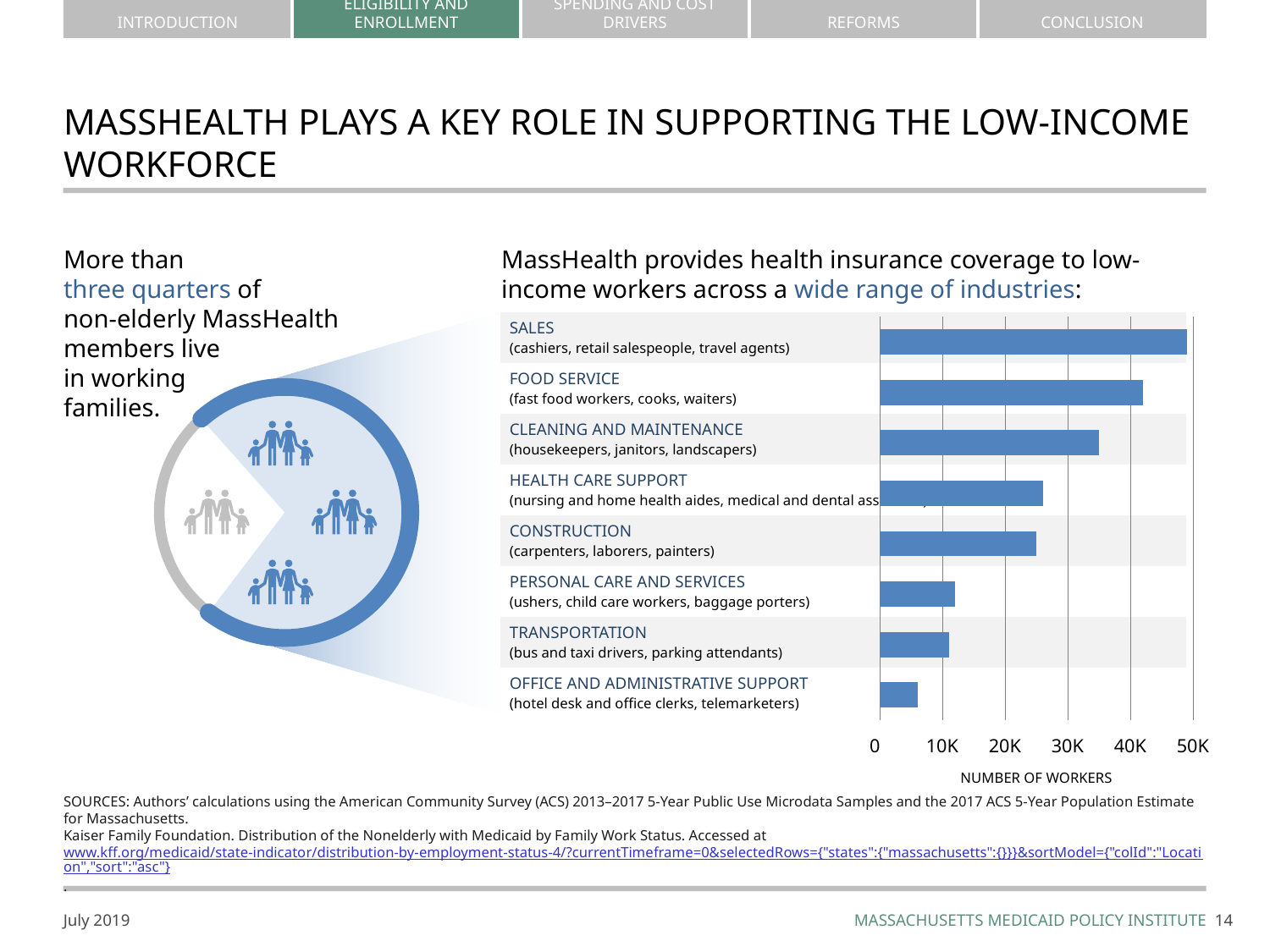
What kind of chart is shown on the slide? bar chart Which occupation category has the lowest number of workers in the chart? Office and Administrative Support How many occupation categories are shown in the bar chart? 8 Which has more workers, Cleaning and Maintenance or Construction? Cleaning and Maintenance Which has more workers, Food Service or Personal Care and Services? Food Service What is the label on the horizontal axis of the chart? NUMBER OF WORKERS Is the number of workers for Sales greater or less than 40K? greater Is the number of workers for Health Care Support greater or less than 20K? greater Is the number of workers for Cleaning and Maintenance greater or less than 30K? greater Which occupation category has the highest number of workers in the chart? Sales